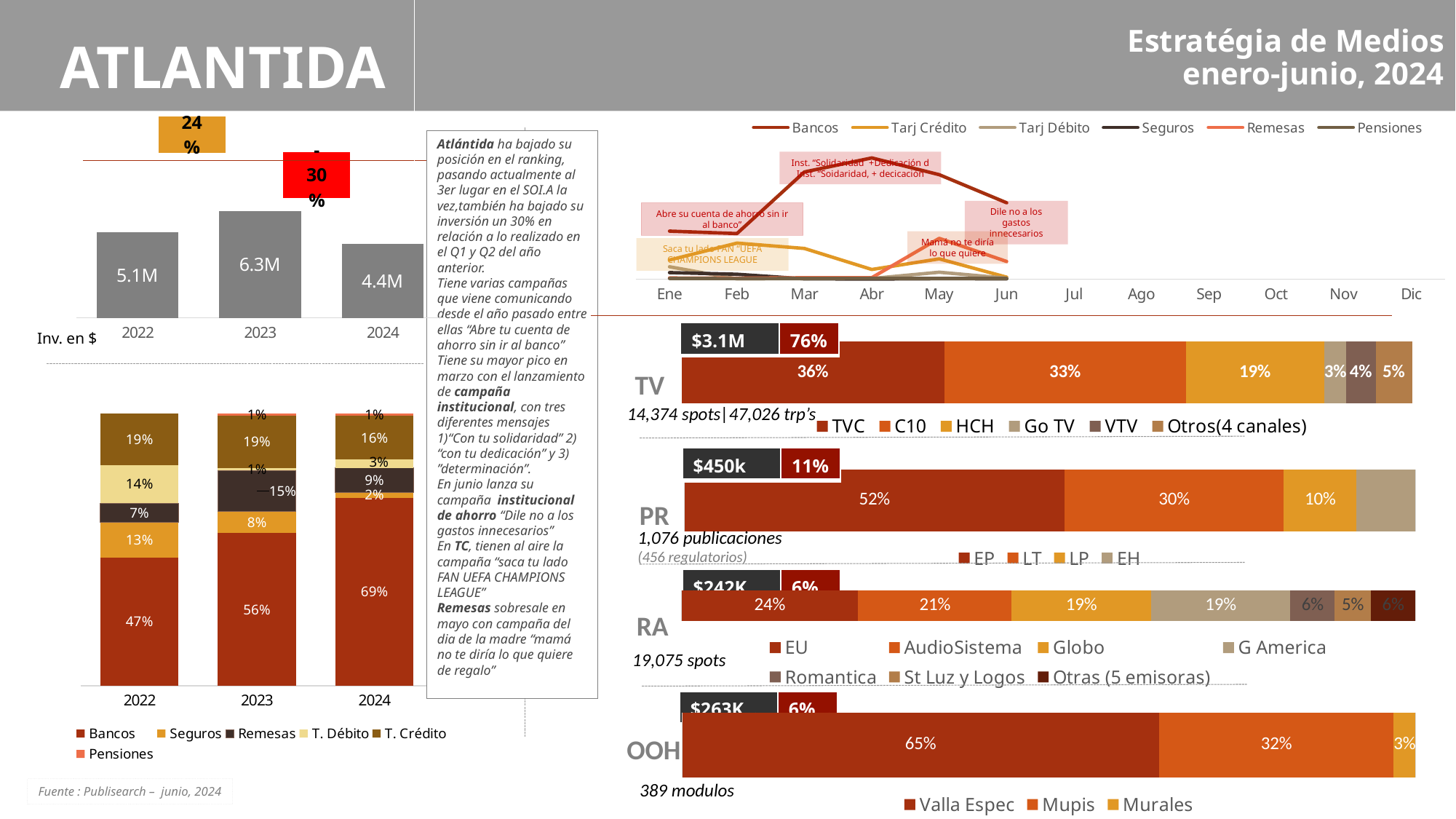
In the 'Inv. en $' bar chart at the top left, what is the value for 2023? 6.3M In the line chart at the top right, how many series does the legend list? 6 In the 'Inv. en $' bar chart at the top left, what kind of chart is it? bar chart In the TV stacked bar, what is the share for C10? 33% In the stacked bar chart at the bottom left, what is the share for Bancos in 2024? 69% In the stacked bar chart at the bottom left, what is the difference between the Bancos share in 2023 and in 2022? 9% In the stacked bar chart at the bottom left, how many series does the legend list? 6 In the OOH stacked bar, what is the share for Mupis? 32% In the line chart at the top right, how many months are shown on the x axis? 12 In the PR stacked bar, which is larger, EP or LT? EP In the TV stacked bar, which channel has the largest share? TVC In the 'Inv. en $' bar chart at the top left, which year has the lowest investment? 2024